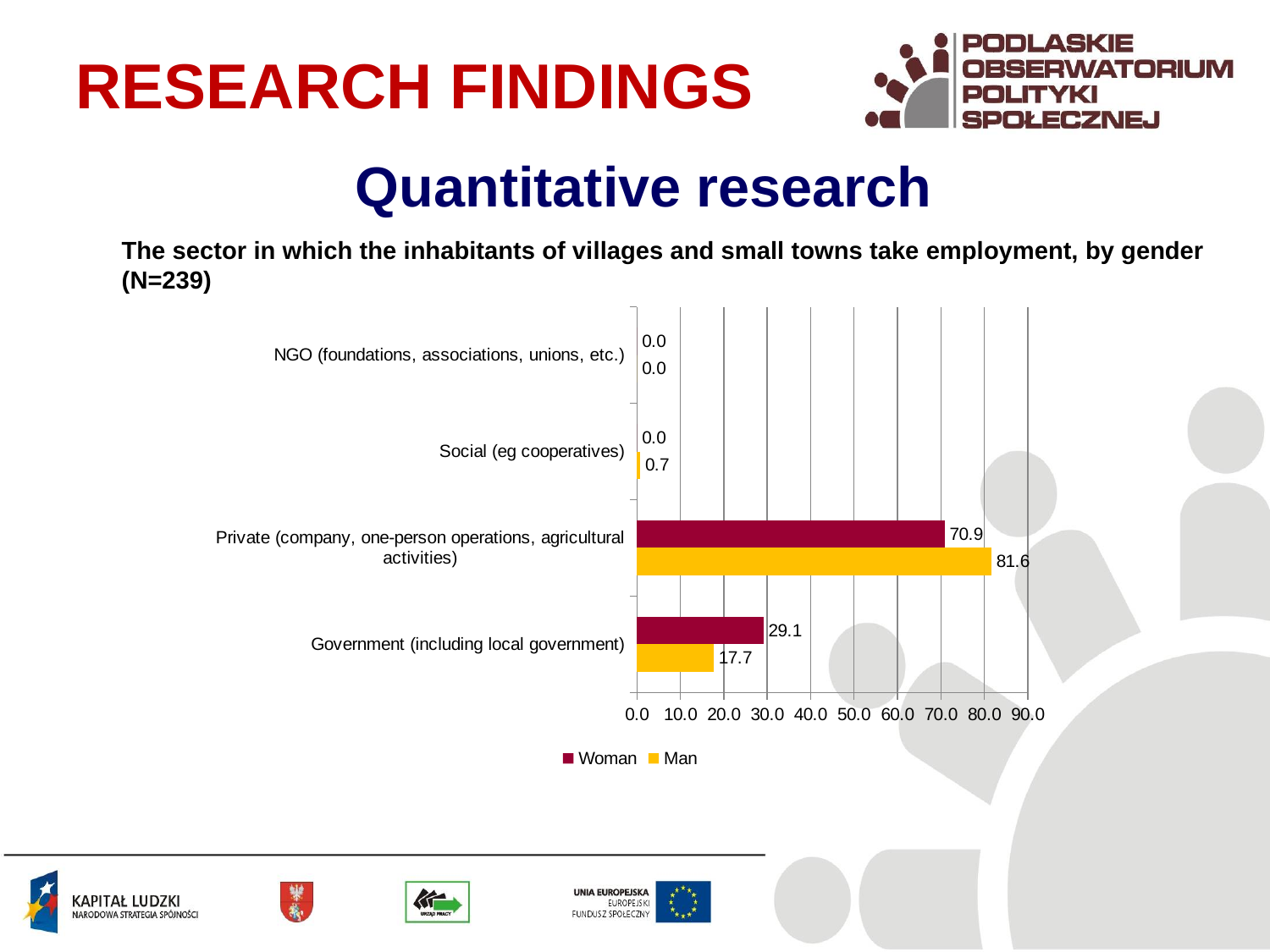
What is the difference between the Woman and Man values in the Government (including local government) category? 11.4 Is the value for Man in the Private (company, one-person operations, agricultural activities) category greater or less than 80.0? greater What is the value for Woman in the Private (company, one-person operations, agricultural activities) category? 70.9 How many series does the legend list? 2 How many categories are shown on the chart? 4 What is the value for Man in the Social (eg cooperatives) category? 0.7 What is the difference between the Man and Woman values in the Private (company, one-person operations, agricultural activities) category? 10.7 What is the value for Man in the Government (including local government) category? 17.7 What is the value for Woman in the Government (including local government) category? 29.1 In the Government (including local government) category, which is larger, the Woman value or the Man value? Woman Which category has the highest value for Man? Private (company, one-person operations, agricultural activities) What kind of chart is shown on the slide? Bar chart